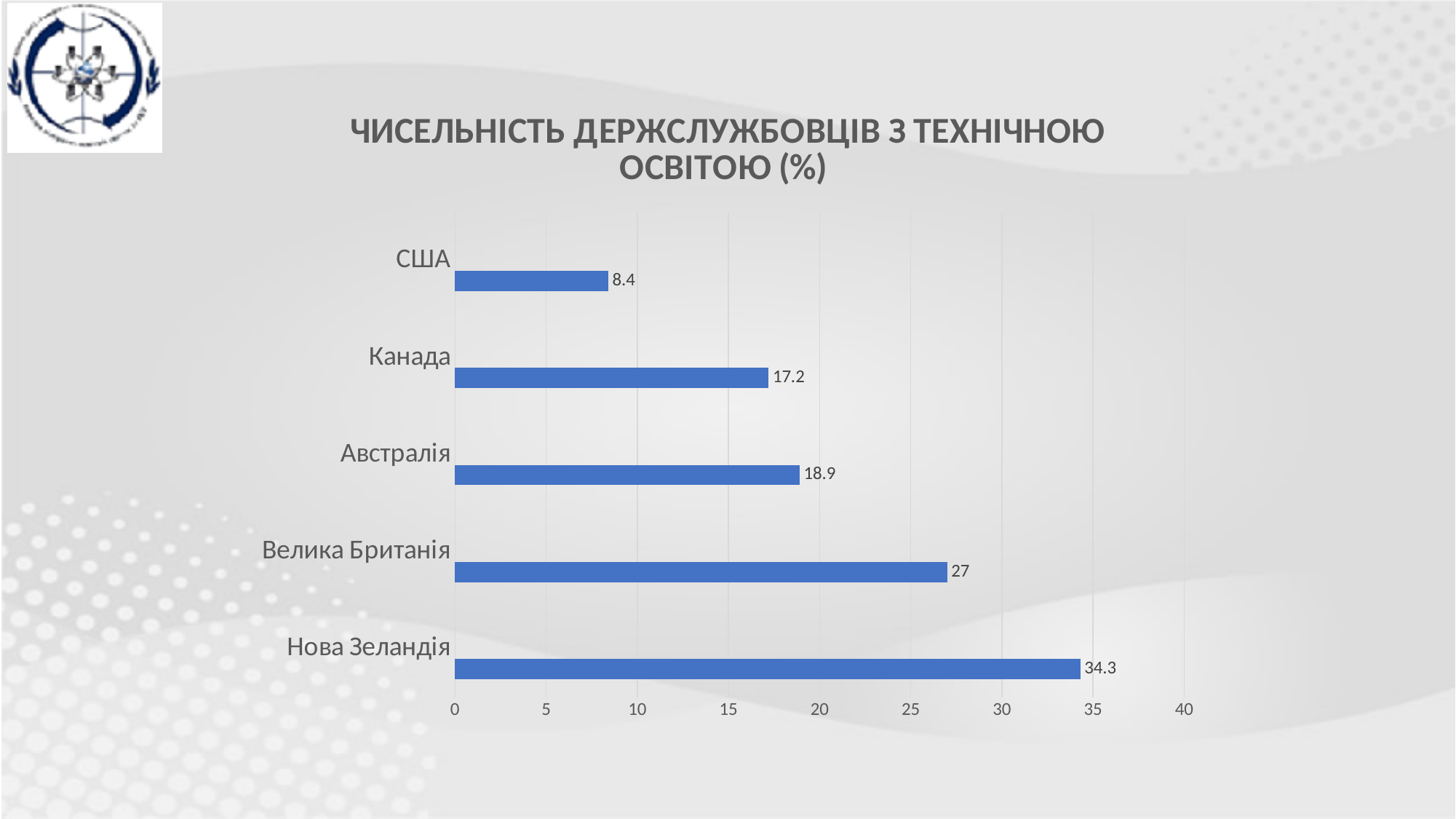
How many countries are shown in the chart? 5 What is the difference between the values for Нова Зеландія and Велика Британія? 7.3 What is the value for Австралія? 18.9 What is the value for Нова Зеландія? 34.3 What is the value for Канада? 17.2 What is the title of the chart? ЧИСЕЛЬНІСТЬ ДЕРЖСЛУЖБОВЦІВ З ТЕХНІЧНОЮ ОСВІТОЮ (%) What is the value for Велика Британія? 27 Which is larger, the value for Канада or the value for Австралія? Австралія What kind of chart is shown on the slide? Bar chart Which country has the lowest value? США What is the value for США? 8.4 Which country has the highest value? Нова Зеландія